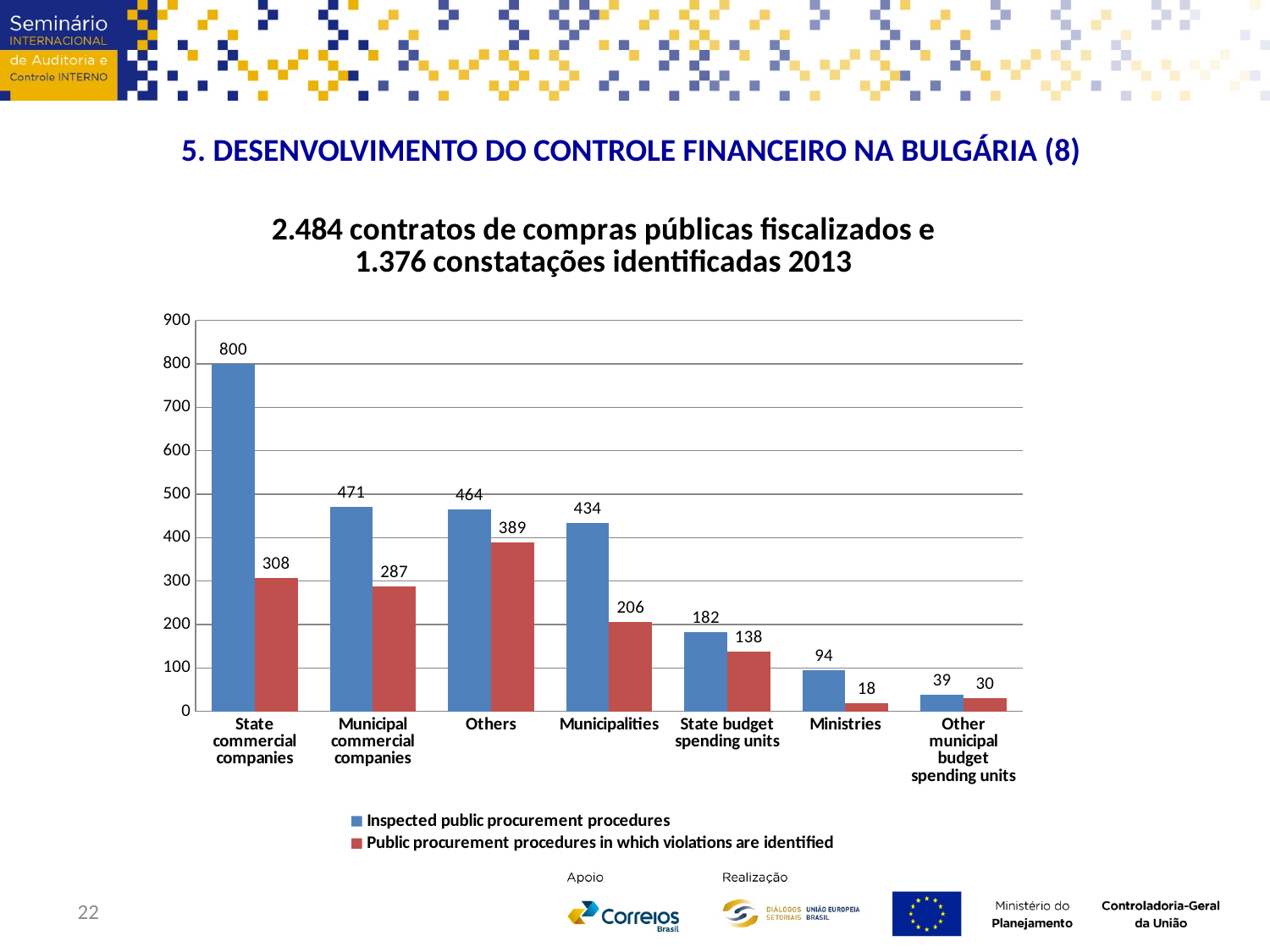
What is the title of the chart? 2.484 contratos de compras públicas fiscalizados e 1.376 constatações identificadas 2013 Which is larger: Inspected public procurement procedures for Municipal commercial companies or for Others? Municipal commercial companies How many series does the legend list? 2 What kind of chart is shown on the slide? Bar chart What is the value of Inspected public procurement procedures for Ministries? 94 How many categories are shown on the x axis? 7 Do the values for Inspected public procurement procedures rise or fall from left to right along the x axis? Fall What is the value of Public procurement procedures in which violations are identified for Others? 389 What is the value of Inspected public procurement procedures for State commercial companies? 800 Which category has the lowest value for Public procurement procedures in which violations are identified? Ministries Which category has the highest value for Inspected public procurement procedures? State commercial companies What is the difference between Inspected public procurement procedures and Public procurement procedures in which violations are identified for Municipalities? 228